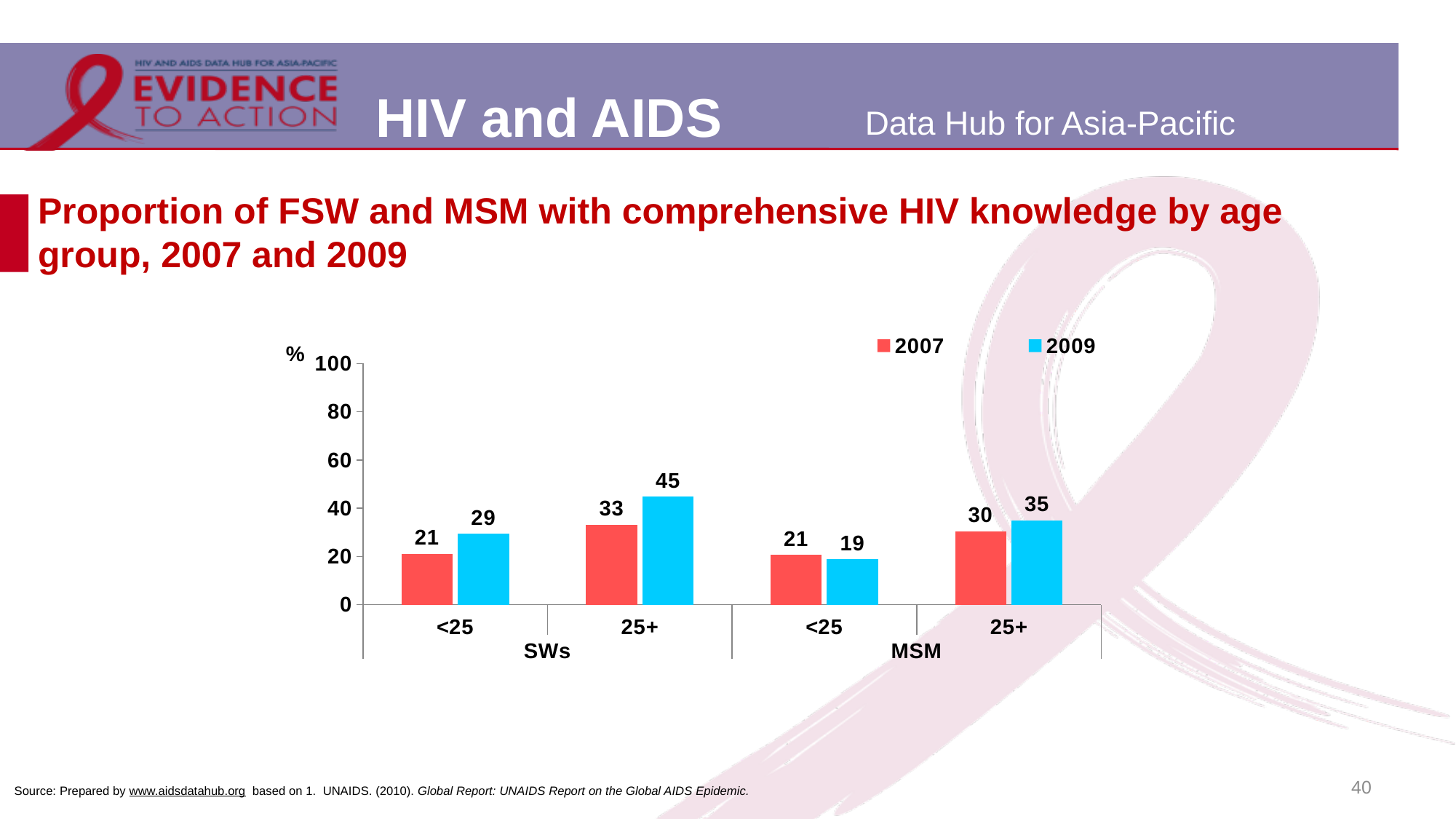
What is the 2007 value for MSM aged <25? 21 How many series does the legend list? 2 Which group and age category has the highest 2009 value? SWs 25+ Which is larger for SWs aged <25: the 2007 value or the 2009 value? 2009 What kind of chart is shown on the slide? Bar chart What is the 2009 value for SWs aged 25+? 45 How many age-group categories are plotted on the x axis? 4 Which group and age category has the lowest 2009 value? MSM <25 What is the 2009 value for MSM aged 25+? 35 What is the difference between the 2007 and 2009 values for MSM aged <25? 2 What is the difference between the 2009 and 2007 values for SWs aged 25+? 12 What colour represents the 2009 series? Blue